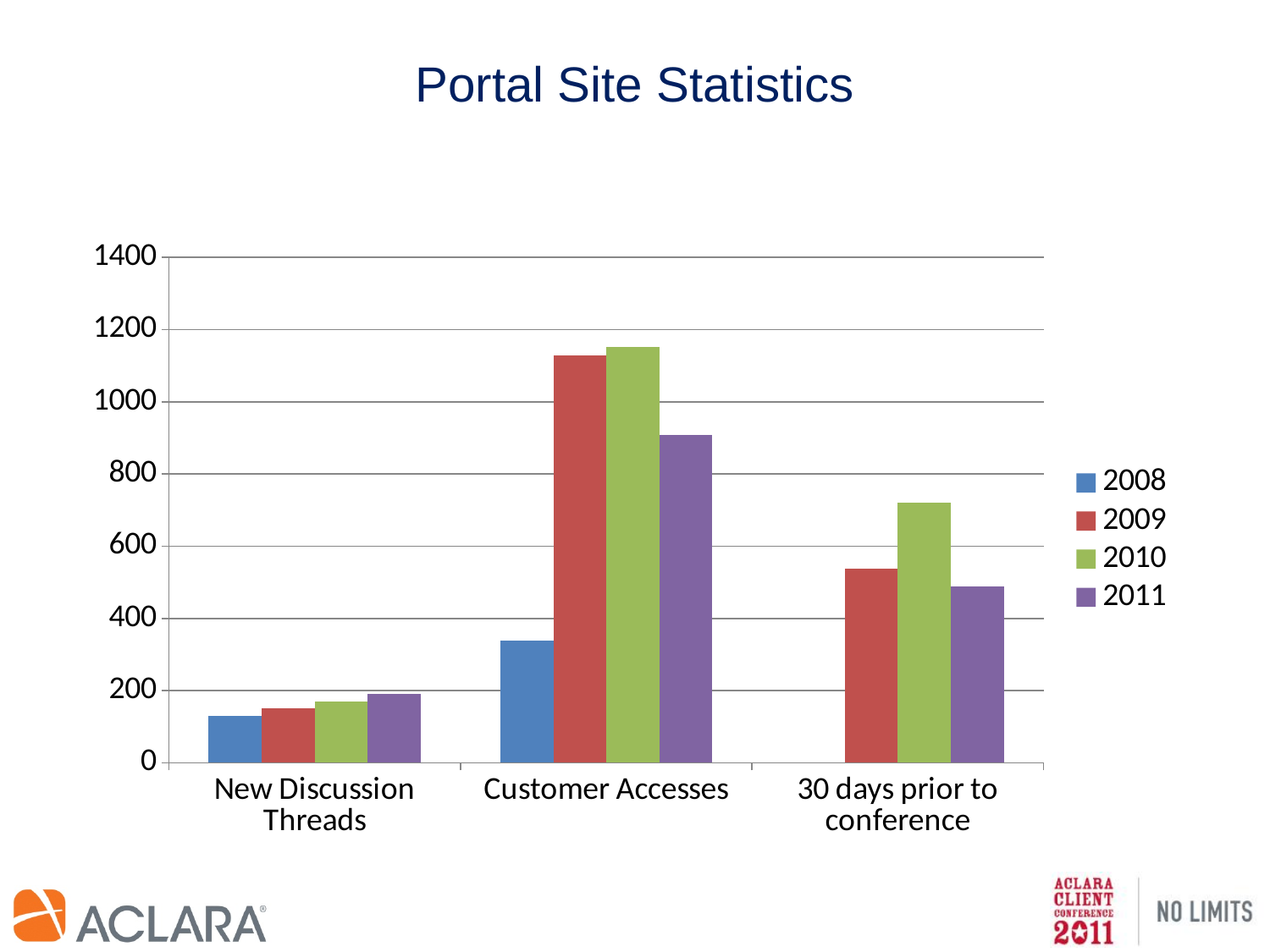
Which year has no bar in the 30 days prior to conference category? 2008 For Customer Accesses, which year has the larger value, 2008 or 2011? 2011 Is the 2008 value for Customer Accesses greater or less than 400? less What kind of chart is shown on the slide? bar chart Which category has the lowest values overall? New Discussion Threads For 30 days prior to conference, which year has the larger value, 2010 or 2011? 2010 Is the 2010 value for Customer Accesses greater or less than 1000? greater How many series does the legend list? 4 How many categories are shown on the x axis? 3 Is the 2010 value for 30 days prior to conference greater or less than 600? greater Which category has the highest values overall? Customer Accesses